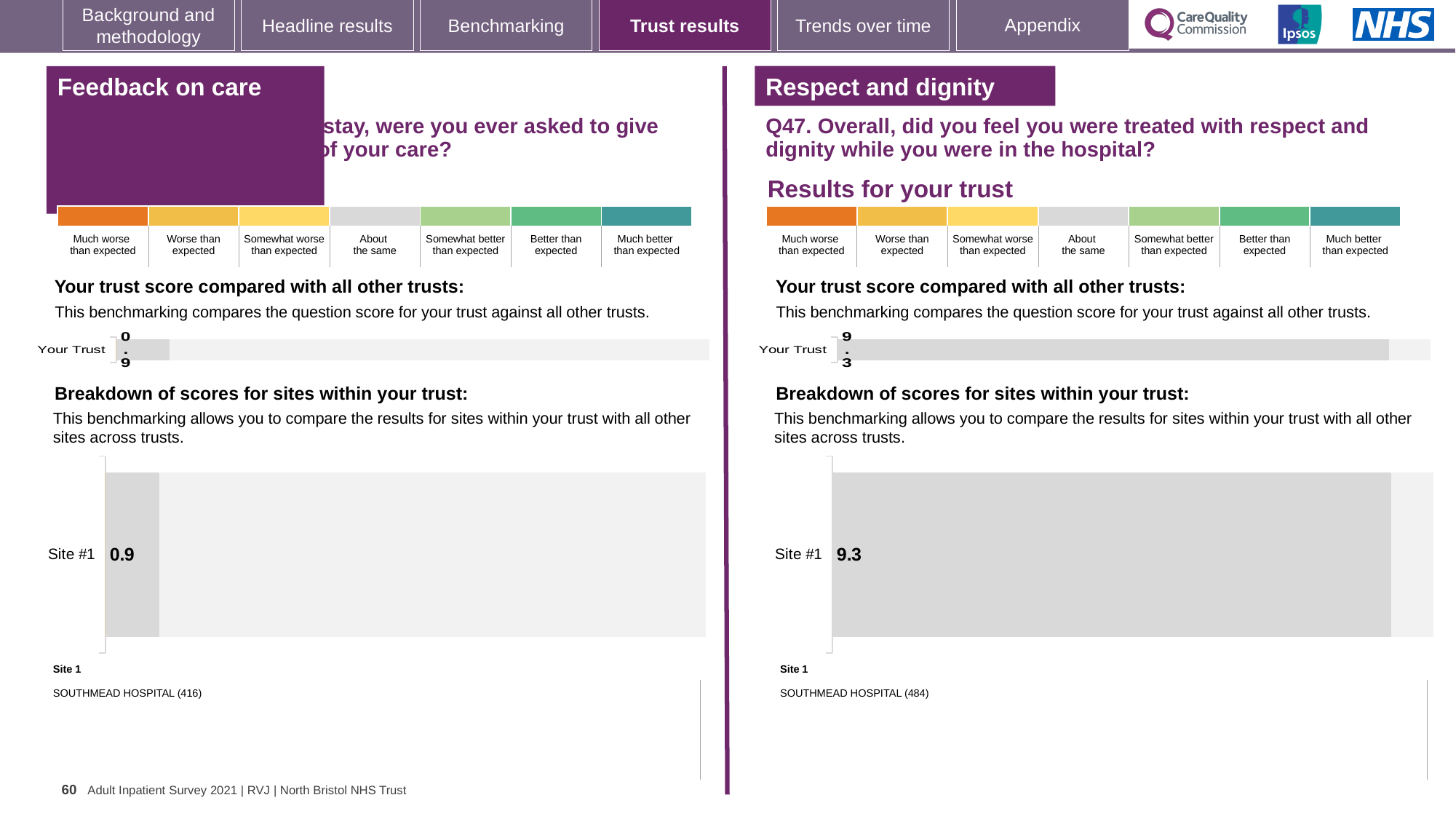
How many sites are shown in the 'Breakdown of scores for sites within your trust' chart on the right-hand 'Respect and dignity' section? 1 What type of chart is used to show the Site #1 score in the 'Respect and dignity' section? Bar chart On the right-hand 'Respect and dignity' section, what is the score shown for Your Trust? 9.3 Is the Your Trust score in the 'Respect and dignity' section greater or less than the Your Trust score in the 'Feedback on care' section? greater Which is larger: the Site #1 score in the 'Feedback on care' section or the Site #1 score in the 'Respect and dignity' section? Respect and dignity Which site is listed as Site 1 beneath the 'Respect and dignity' site breakdown chart? SOUTHMEAD HOSPITAL (484) On the left-hand 'Feedback on care' section, what is the score shown for Your Trust? 0.9 What is the difference between the Site #1 score in the 'Respect and dignity' section and the Site #1 score in the 'Feedback on care' section? 8.4 In the 'Breakdown of scores for sites within your trust' chart on the right-hand 'Respect and dignity' section, what is the score for Site #1? 9.3 In the 'Breakdown of scores for sites within your trust' chart on the left-hand 'Feedback on care' section, what is the score for Site #1? 0.9 How many sites are shown in the 'Breakdown of scores for sites within your trust' chart on the left-hand 'Feedback on care' section? 1 Which site is listed as Site 1 beneath the 'Feedback on care' site breakdown chart? SOUTHMEAD HOSPITAL (416)